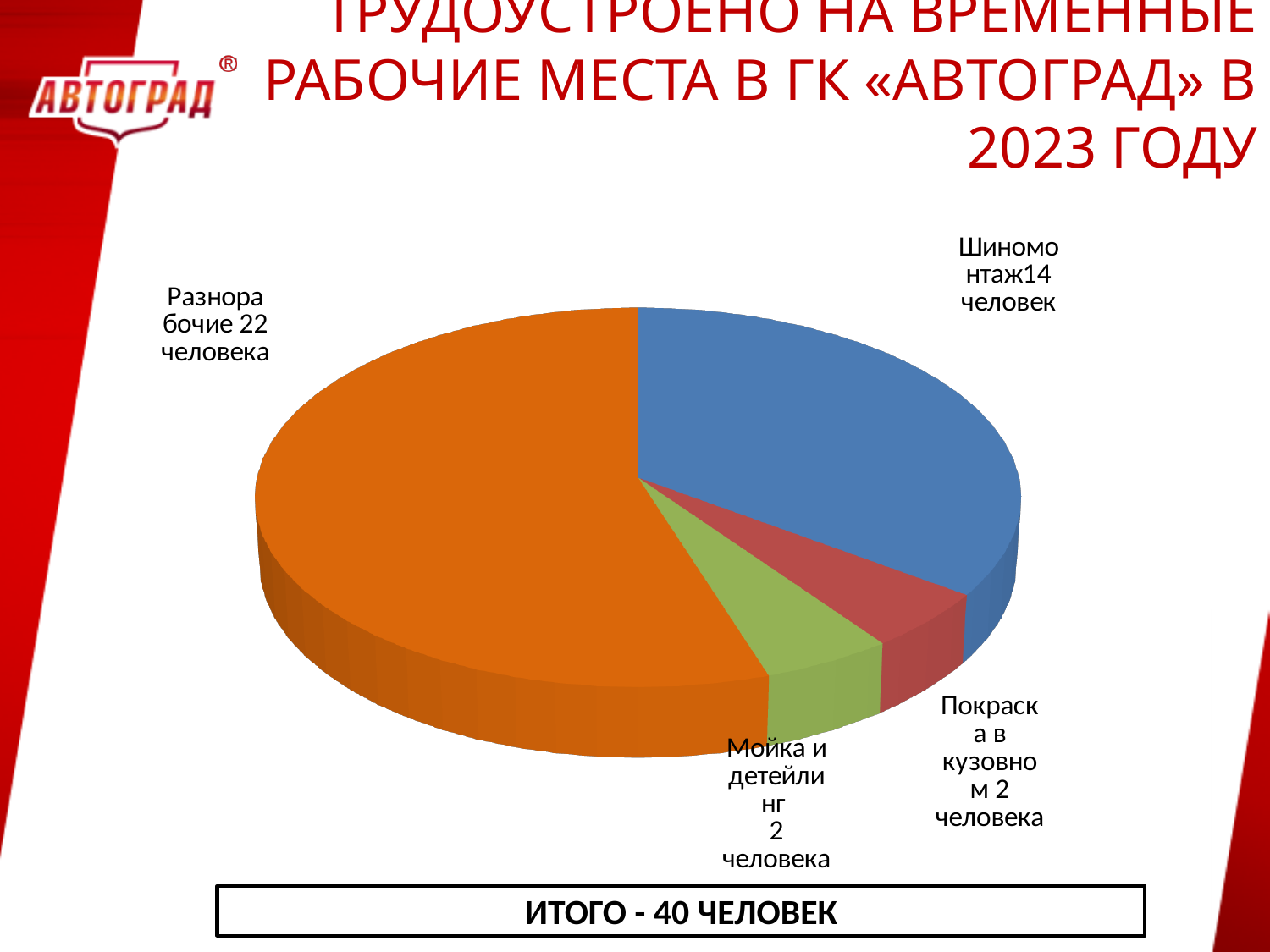
What share of the total does the Разнорабочие slice represent? 55% What is the difference in people between Разнорабочие and Шиномонтаж? 8 Which is larger: Шиномонтаж or Покраска в кузовном? Шиномонтаж How many people were employed as Разнорабочие according to the pie chart? 22 человека What type of chart is shown on the slide? Pie chart What share of the total does the Шиномонтаж slice represent? 35% How many people were employed in Мойка и детейлинг? 2 человека Which category has the largest slice of the pie? Разнорабочие How many categories (slices) does the pie chart have? 4 What is the total number of people shown in the chart, as stated on the slide? 40 человек What colour is the Разнорабочие slice? Orange How many people does the Шиномонтаж slice represent? 14 человек